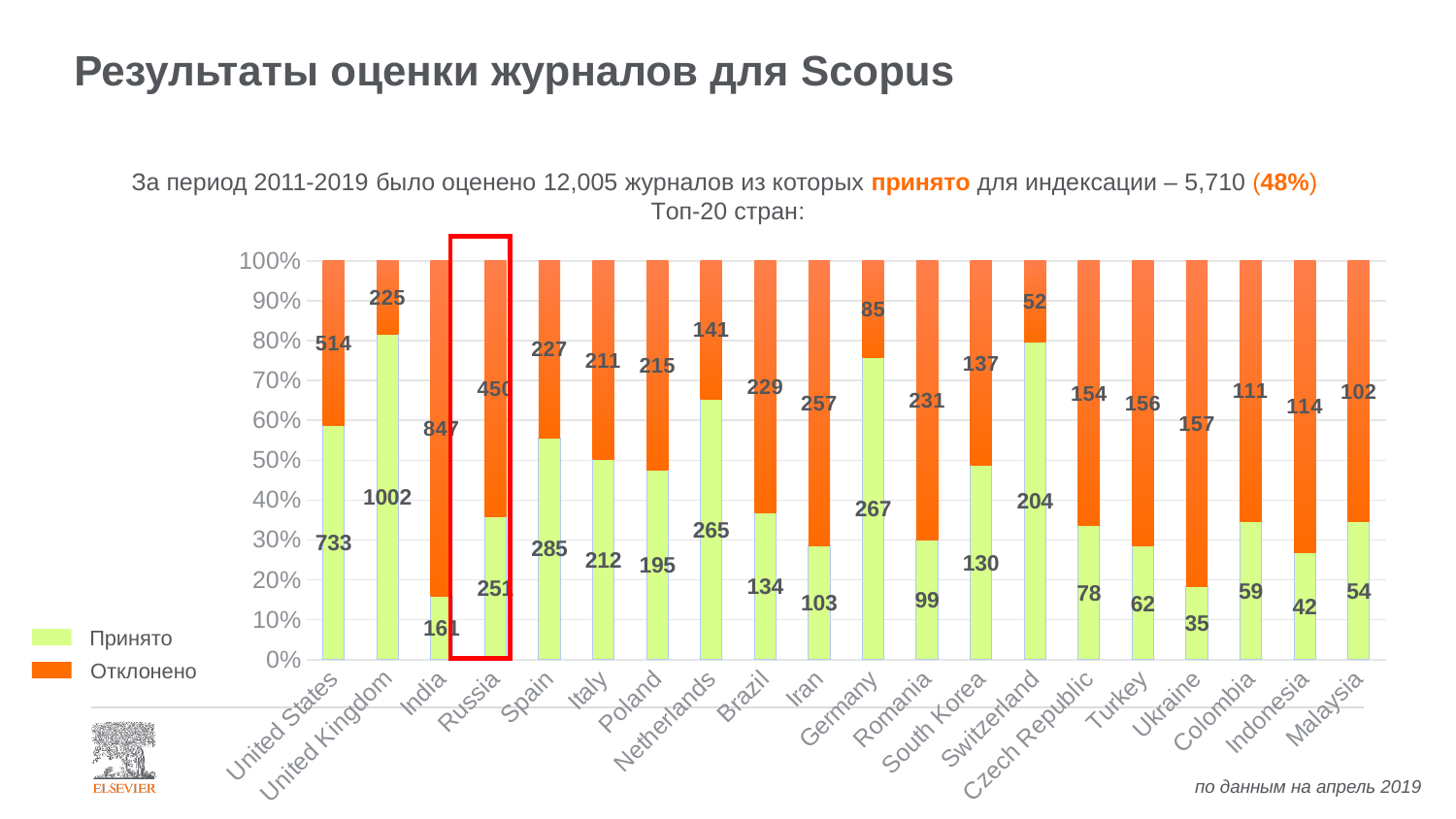
What kind of chart is shown on the slide? Stacked bar chart What is the total number of journals (Принято plus Отклонено) for Russia? 701 How many countries are shown on the x axis of the chart? 20 Which is larger for Germany: the Принято value or the Отклонено value? Принято Which country has the highest Принято (accepted) value? United Kingdom Which country has the lowest Принято (accepted) value? Ukraine Which country's bar is highlighted with a red box on the chart? Russia How many series does the chart legend list? 2 What is the Принято value for Switzerland? 204 What is the Отклонено (rejected) value for India? 847 What is the difference between the Принято and Отклонено values for the United States? 219 What is the Принято (accepted) value for Russia? 251